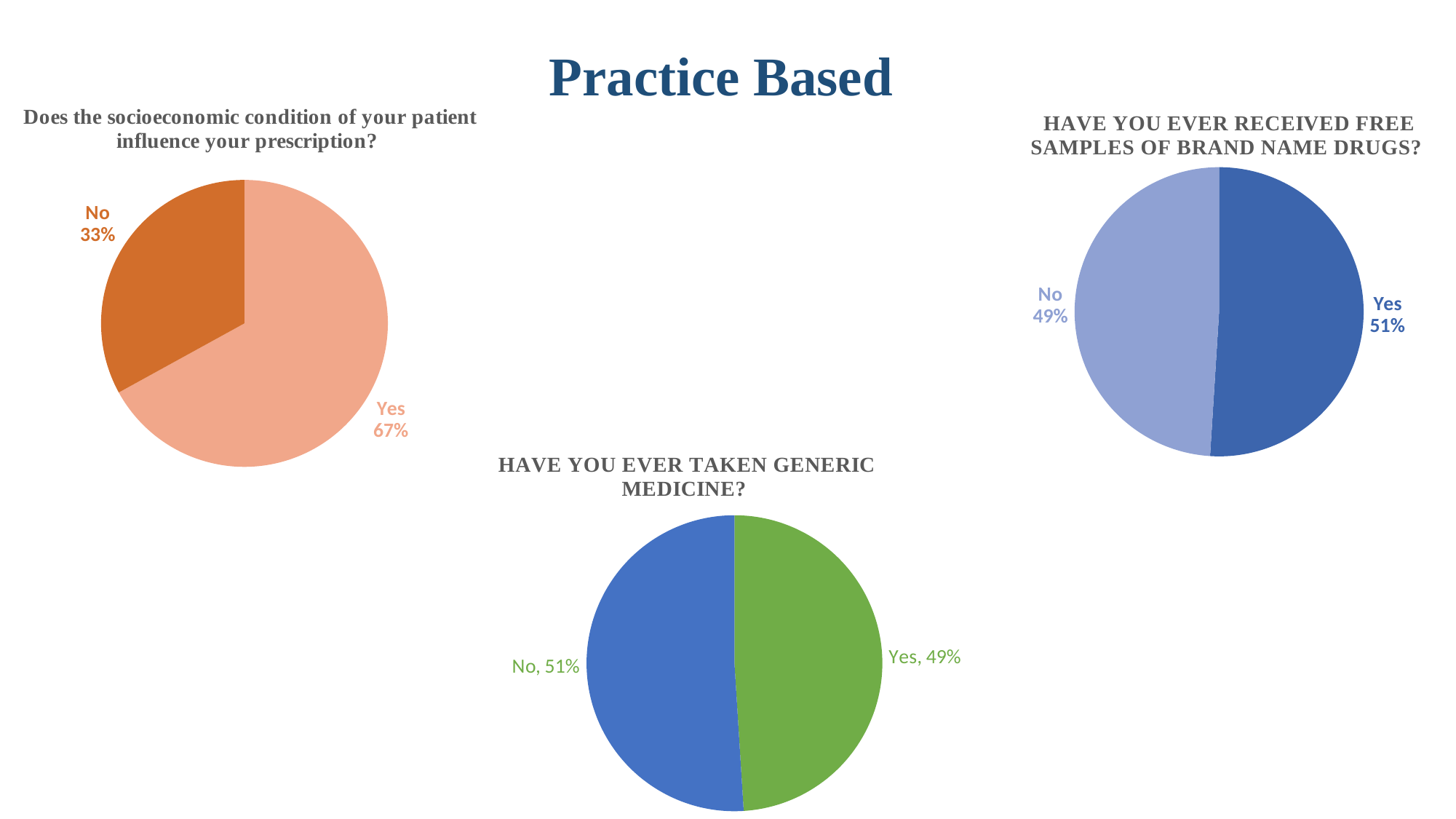
In the chart titled "HAVE YOU EVER RECEIVED FREE SAMPLES OF BRAND NAME DRUGS?", what share of the pie is "Yes"? 51% In the chart titled "Does the socioeconomic condition of your patient influence your prescription?", what is the difference in percentage points between the "Yes" and "No" slices? 34 What kind of chart is the one titled "HAVE YOU EVER TAKEN GENERIC MEDICINE?"? Pie chart In the chart titled "HAVE YOU EVER TAKEN GENERIC MEDICINE?", what share of the pie is "Yes"? 49% In the chart titled "HAVE YOU EVER RECEIVED FREE SAMPLES OF BRAND NAME DRUGS?", what share of the pie is "No"? 49% In the chart titled "HAVE YOU EVER TAKEN GENERIC MEDICINE?", what is the difference in percentage points between the "No" and "Yes" slices? 2 In the chart titled "Does the socioeconomic condition of your patient influence your prescription?", which slice is the largest? Yes How many pie charts are shown on the slide? 3 How many slices does the chart titled "HAVE YOU EVER RECEIVED FREE SAMPLES OF BRAND NAME DRUGS?" have? 2